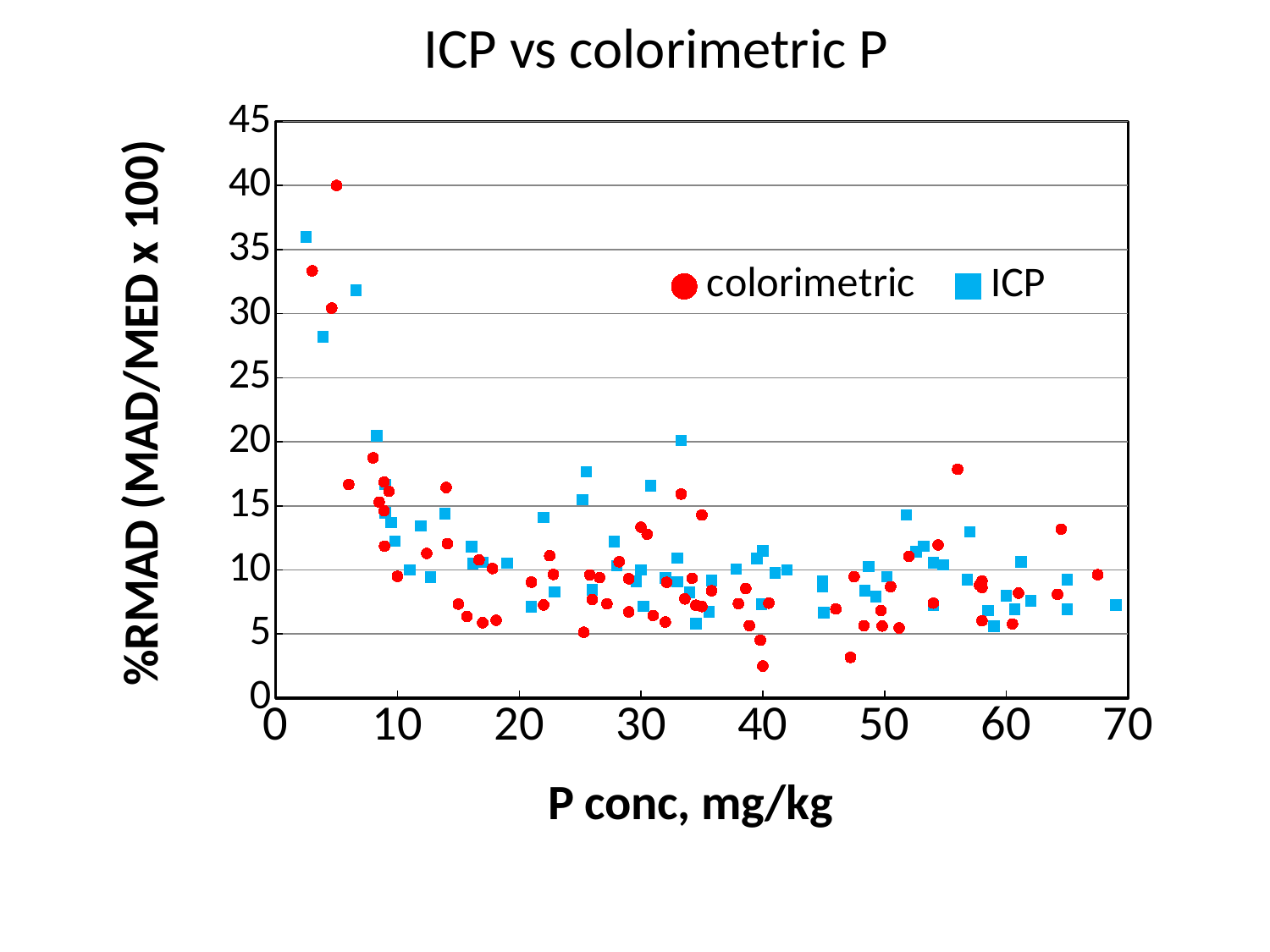
Is the highest colorimetric value greater or less than 35? greater Is the highest ICP value greater or less than 30? greater Is the lowest colorimetric value greater or less than 5? less What kind of chart is shown on the slide? scatter chart Which series has the single highest %RMAD point, colorimetric or ICP? colorimetric How many series does the legend list? 2 What is the title of the chart? ICP vs colorimetric P Do the %RMAD values generally rise or fall as P conc increases? fall What are the two series named in the legend? colorimetric and ICP